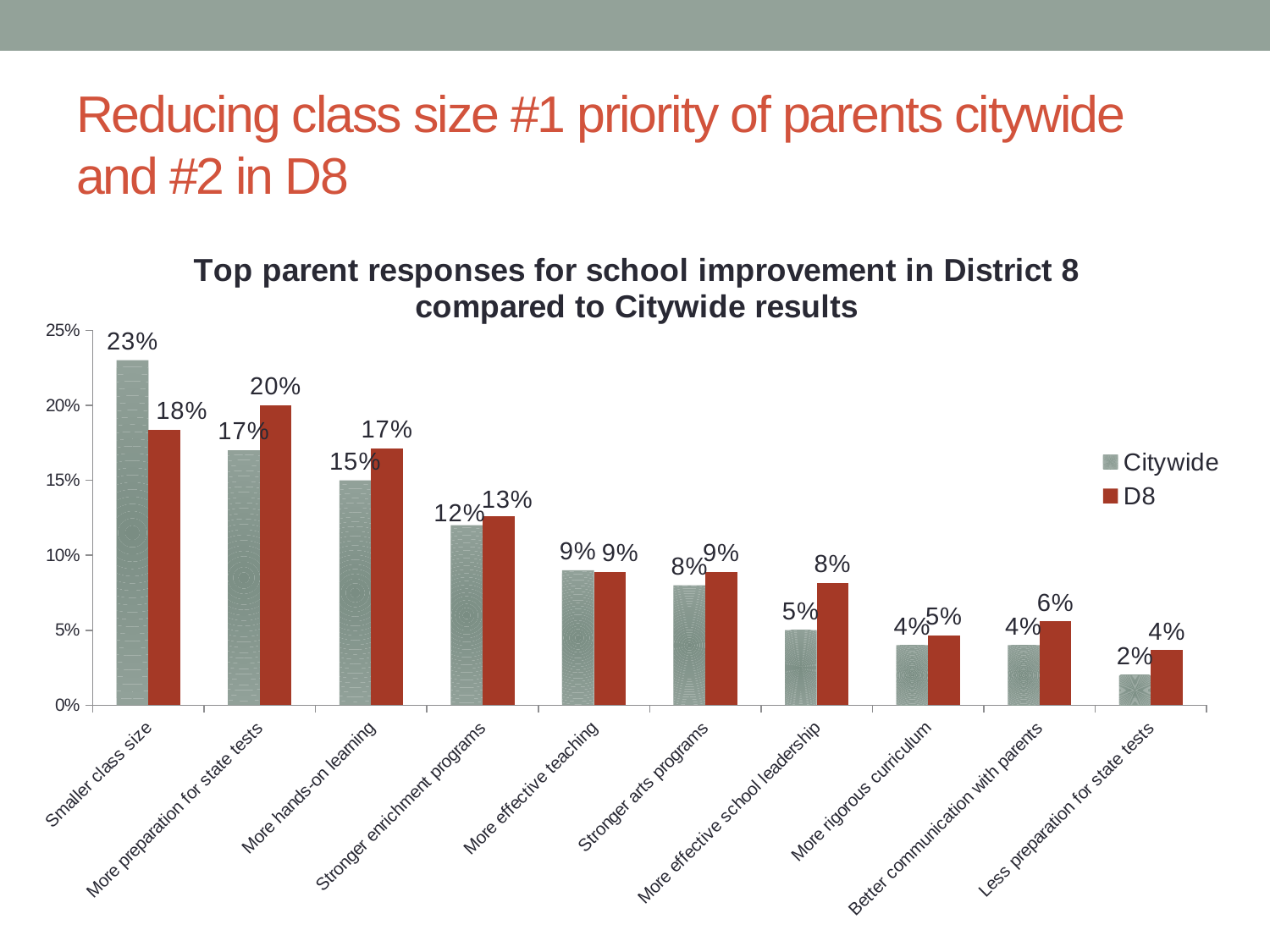
How many categories are shown on the x axis? 10 What is the title of the chart? Top parent responses for school improvement in District 8 compared to Citywide results What kind of chart is shown on the slide? Bar chart What is the D8 value for More effective school leadership? 8% Which category has the lowest Citywide value? Less preparation for state tests Which category has the highest D8 value? More preparation for state tests Which is larger for More hands-on learning, the Citywide value or the D8 value? D8 What is the Citywide value for Smaller class size? 23% How many series does the legend list? 2 What is the difference between the Citywide and D8 values for Smaller class size? 5% What is the D8 value for More preparation for state tests? 20% Do the Citywide values rise or fall moving from left to right along the x axis? Fall